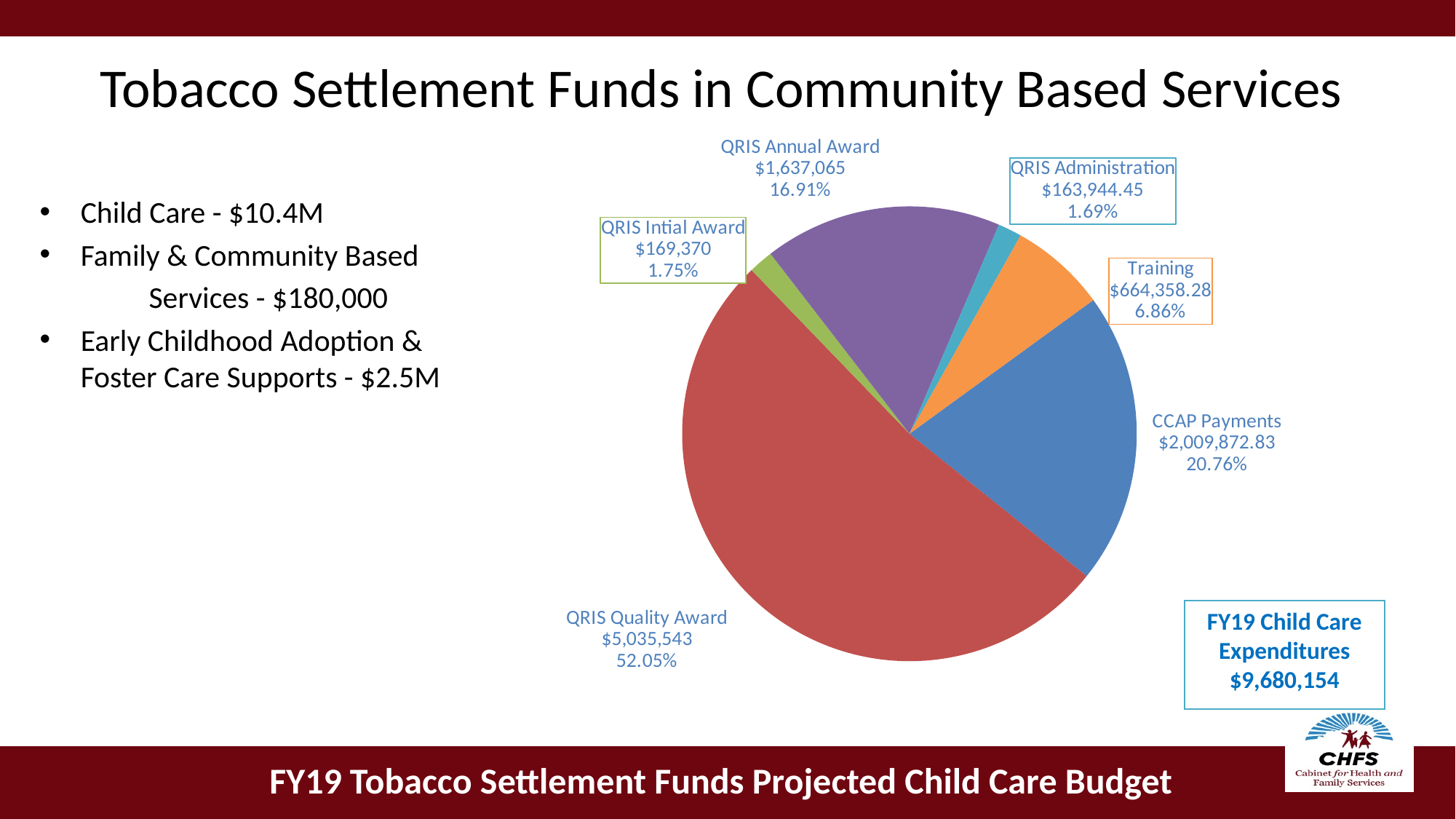
What is the value shown for QRIS Quality Award? $5,035,543 What is the value shown for QRIS Administration? $163,944.45 Which is larger, CCAP Payments or QRIS Annual Award? CCAP Payments How many slices does the pie chart have? 6 What percentage share of the pie does QRIS Intial Award represent? 1.75% What percentage share of the pie does QRIS Annual Award represent? 16.91% What is the value shown for CCAP Payments? $2,009,872.83 What kind of chart is shown on the slide? Pie chart What is the value shown for Training? $664,358.28 Which category has the smallest slice of the pie? QRIS Administration Which category has the largest slice of the pie? QRIS Quality Award What is the difference between the QRIS Annual Award value and the QRIS Intial Award value? $1,467,695